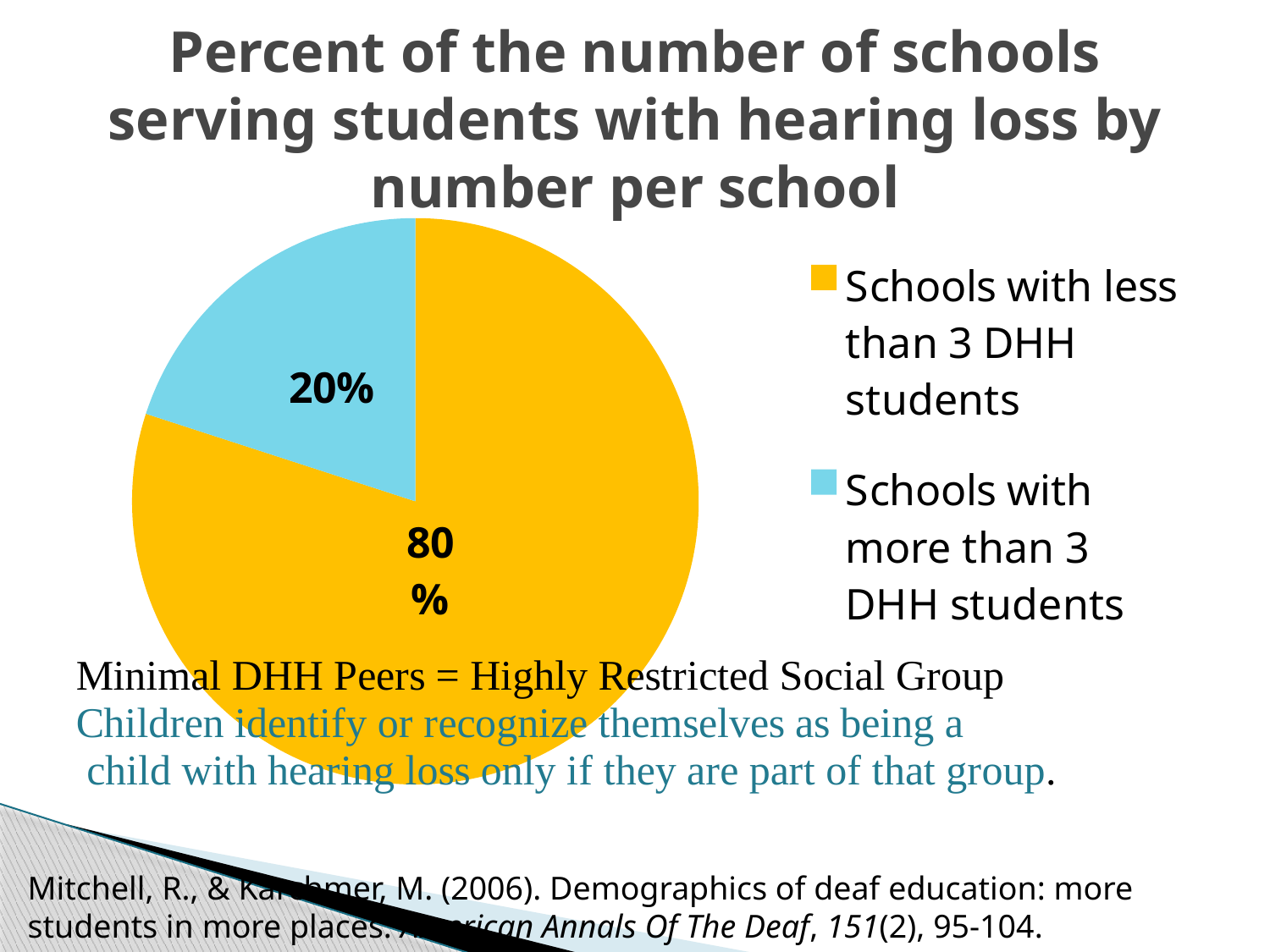
What is the title of the chart? Percent of the number of schools serving students with hearing loss by number per school How many entries does the legend list? 2 What colour is the slice for schools with more than 3 DHH students? light blue How many slices does the pie chart have? 2 Which is larger: the share of schools with less than 3 DHH students or the share with more than 3 DHH students? Schools with less than 3 DHH students What is the difference in percentage points between schools with less than 3 DHH students and schools with more than 3 DHH students? 60 What type of chart is shown on the slide? pie chart What percentage of schools have more than 3 DHH students? 20% Which category has the largest share of the pie? Schools with less than 3 DHH students Which category has the smallest share of the pie? Schools with more than 3 DHH students What percentage of schools have less than 3 DHH students? 80%